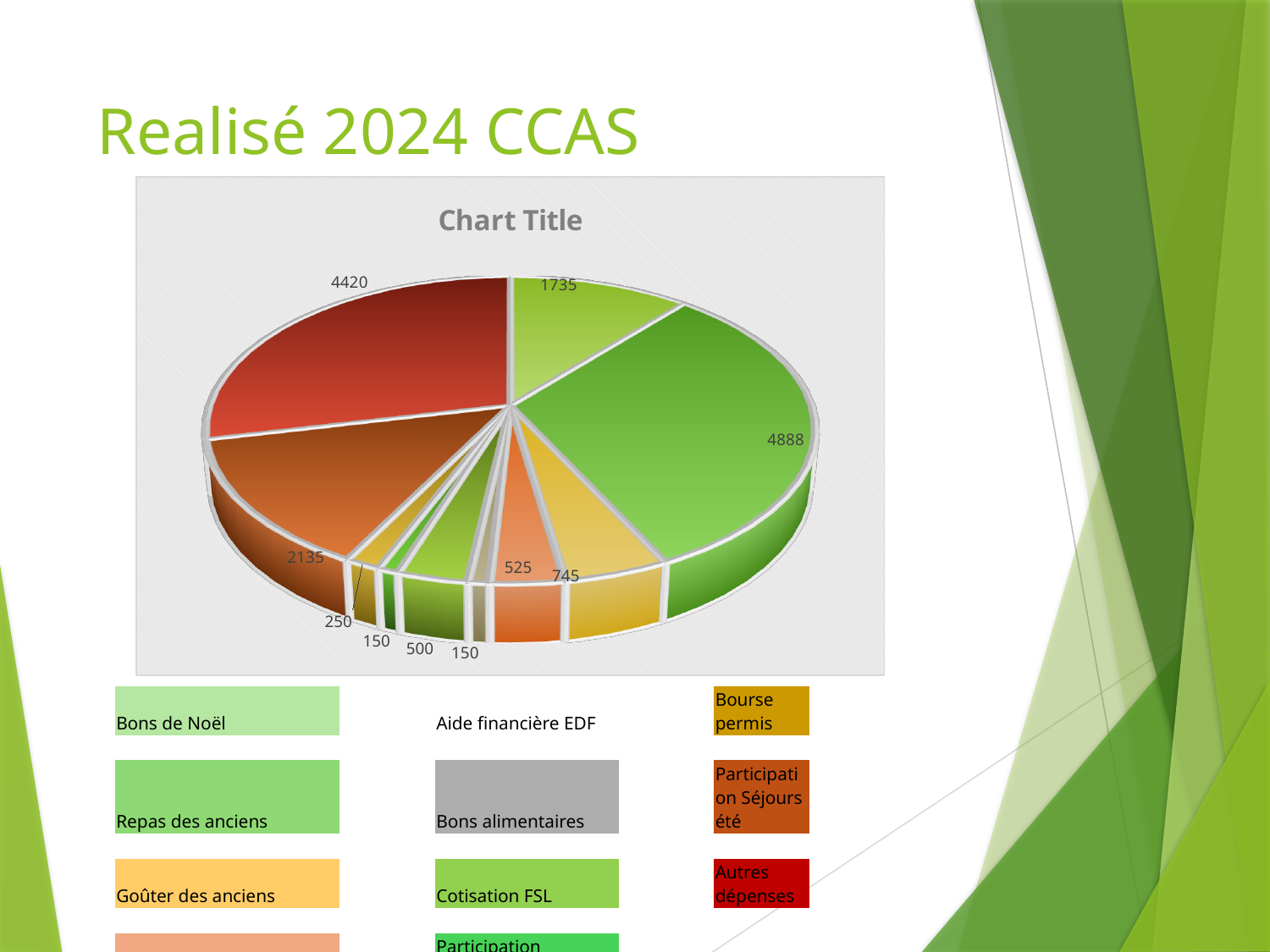
What is the value shown for the Goûter des anciens slice (yellow)? 745 What is the difference between the largest slice (4888) and the Autres dépenses slice (4420)? 468 What is the value of the largest slice in the pie chart? 4888 How many data labels are shown on the pie chart? 10 What is the difference between the Participation Séjours été slice and the Bons de Noël slice? 400 What is the value shown for the Autres dépenses slice (red)? 4420 What kind of chart is shown on the slide? pie chart Which is larger: the Autres dépenses slice or the Participation Séjours été slice? Autres dépenses What is the value shown for the Bons de Noël slice (light green)? 1735 What is the value shown for the Participation Séjours été slice? 2135 What is the smallest value labelled on the pie chart? 150 What is the title printed above the pie chart? Chart Title